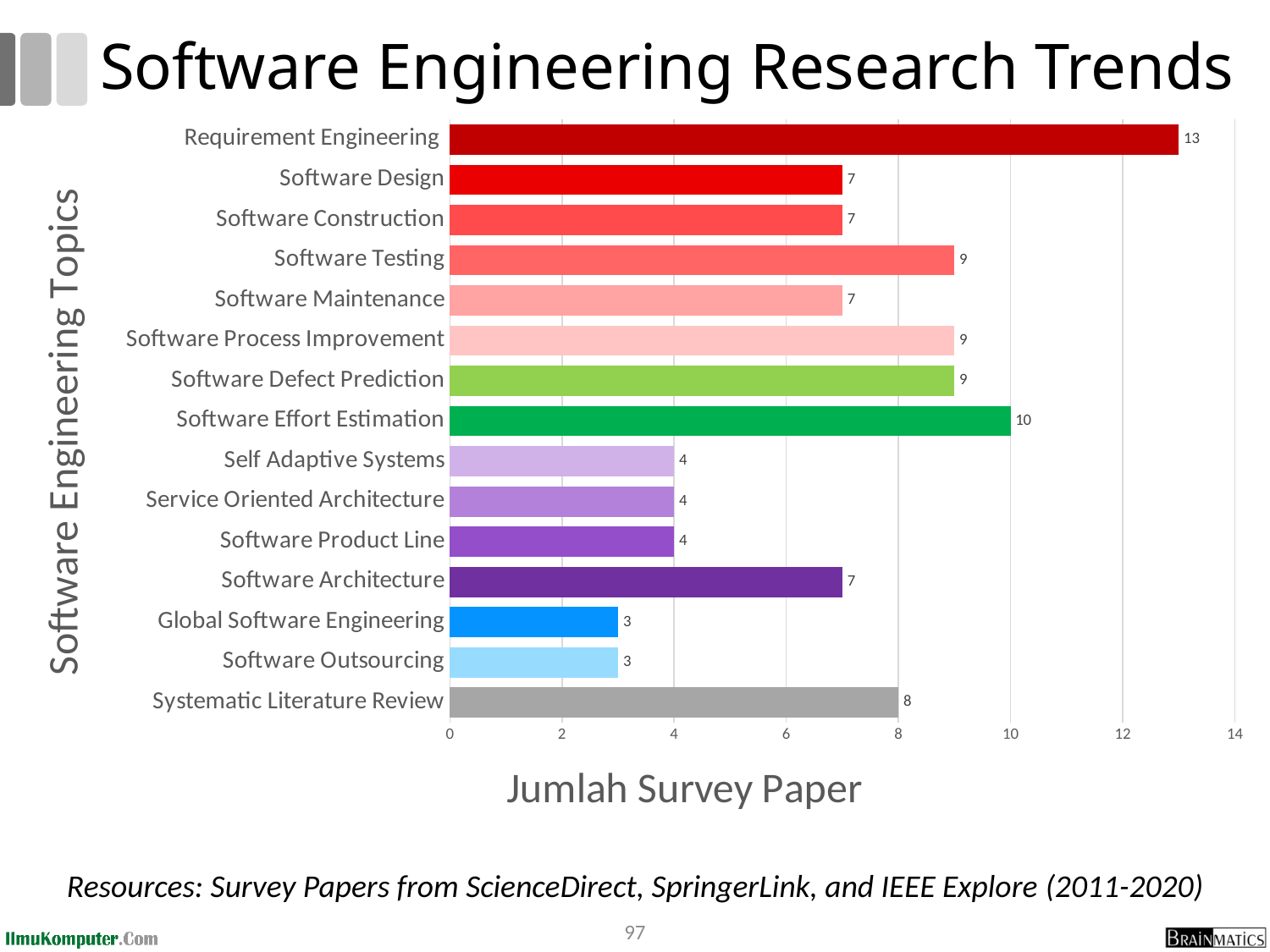
What is the difference between the values for Systematic Literature Review and Software Outsourcing? 5 Which topic has the highest number of survey papers? Requirement Engineering Is the value for Software Architecture greater or less than 6? greater What is the value for Software Effort Estimation? 10 What is the value for Systematic Literature Review? 8 Which is larger, the value for Software Testing or the value for Software Design? Software Testing How many topics are plotted on the chart? 15 How many survey papers are shown for Requirement Engineering? 13 What is the label of the vertical axis? Software Engineering Topics What is the difference between the values for Requirement Engineering and Software Effort Estimation? 3 What is the label of the horizontal axis? Jumlah Survey Paper What kind of chart is shown on the slide? bar chart